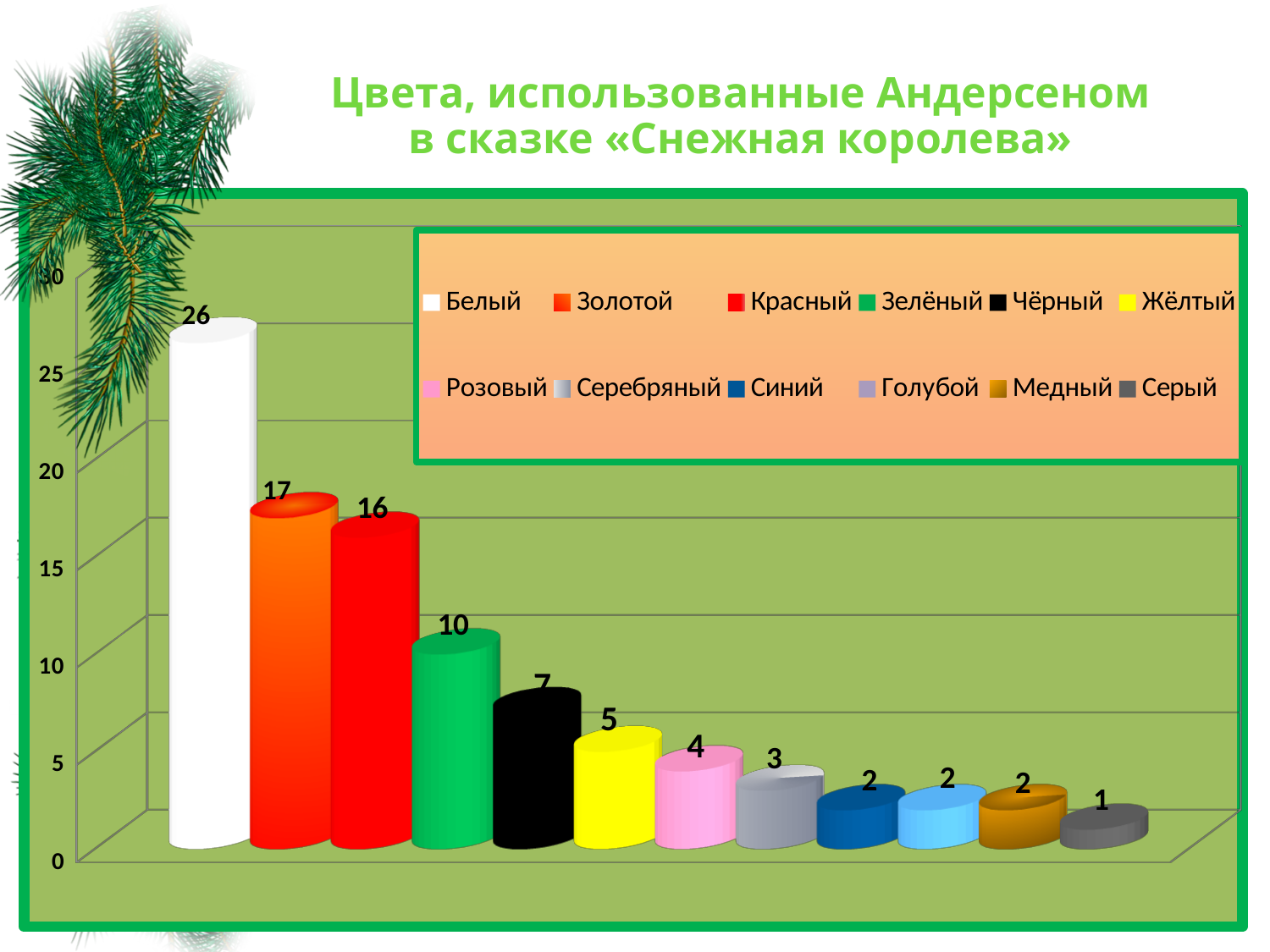
Which colour has the highest value? Белый What kind of chart is shown on the slide? bar chart What is the difference between the values for Красный and Зелёный? 6 What is the difference between the values for Белый and Золотой? 9 How many colours are plotted in the chart? 12 What value is shown for Белый? 26 Which is larger, the value for Жёлтый or the value for Розовый? Жёлтый What value is shown for Чёрный? 7 What value is shown for Зелёный? 10 Which colour has the lowest value? Серый Is the value for Золотой greater or less than 15? greater What is the title of the chart? Цвета, использованные Андерсеном в сказке «Снежная королева»